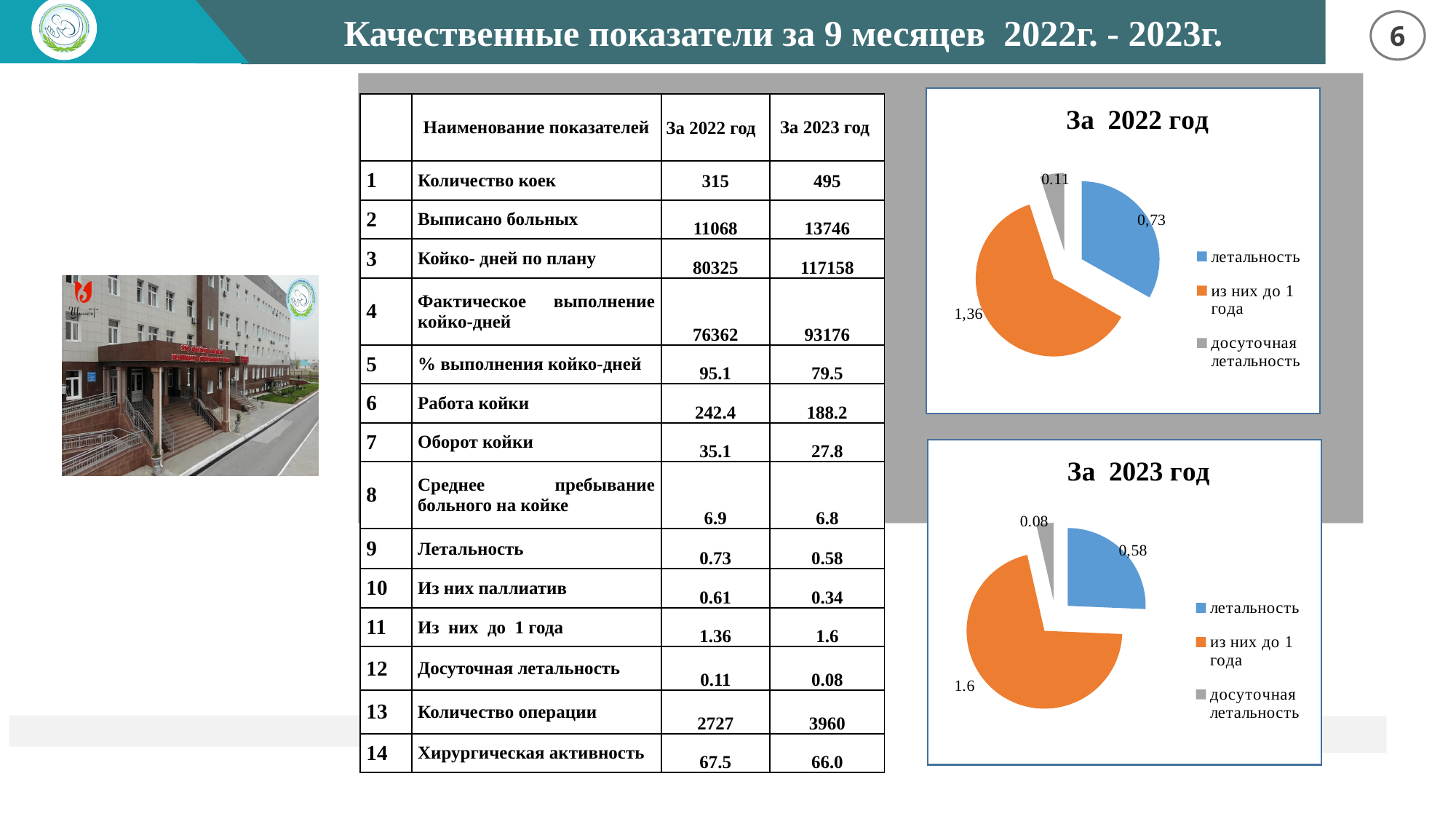
In the chart titled "За 2023 год", what is the value for "летальность"? 0,58 In the chart titled "За 2022 год", what is the value for "из них до 1 года"? 1,36 In the chart titled "За 2022 год", what is the value for "летальность"? 0,73 What kind of chart is the chart titled "За 2022 год"? pie chart In the chart titled "За 2023 год", what colour is the slice for "из них до 1 года"? orange In the chart titled "За 2022 год", which category has the smallest slice? досуточная летальность In the chart titled "За 2023 год", what is the value for "досуточная летальность"? 0.08 In the chart titled "За 2023 год", what is the value for "из них до 1 года"? 1.6 In the chart titled "За 2022 год", which category has the largest slice? из них до 1 года In the chart titled "За 2023 год", which is larger: "летальность" or "досуточная летальность"? летальность In the chart titled "За 2022 год", what is the value for "досуточная летальность"? 0.11 How many categories does the legend of the chart titled "За 2023 год" list? 3